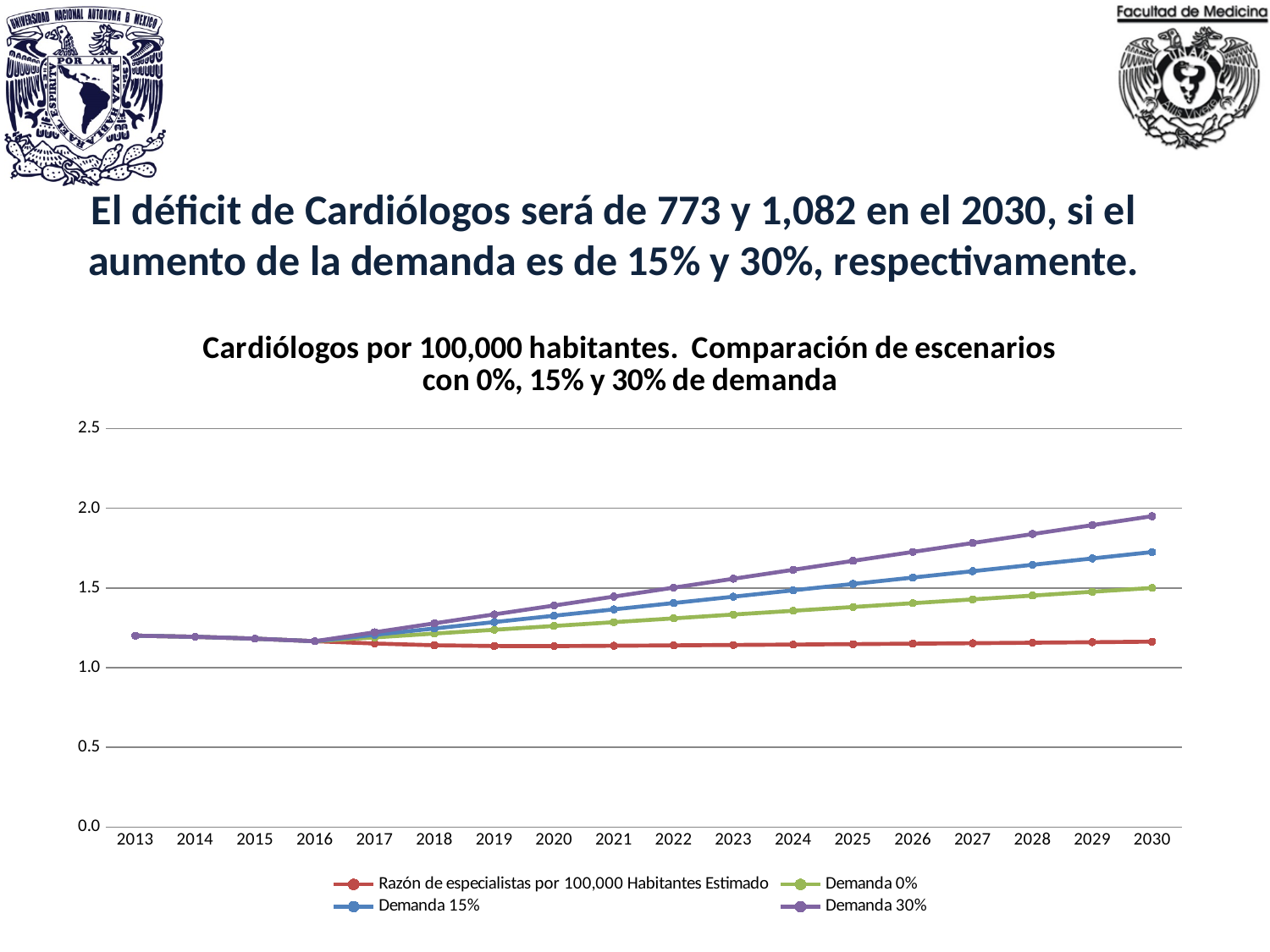
How many years are shown along the x axis? 18 Is the value for Demanda 15% in 2030 greater or less than 1.5? greater Which series has the lowest value in 2030? Razón de especialistas por 100,000 Habitantes Estimado Which series has the highest value in 2030? Demanda 30% How many series does the legend list? 4 Which series is drawn in red? Razón de especialistas por 100,000 Habitantes Estimado Does the Demanda 30% series rise or fall from 2016 to 2030? rise What kind of chart is shown on the slide? line chart Is the value for Razón de especialistas por 100,000 Habitantes Estimado in 2030 greater or less than 1.5? less Is the value for Demanda 30% in 2030 greater or less than 2.0? less In 2030, which is larger: Demanda 15% or Demanda 0%? Demanda 15% What is the first year shown on the x axis? 2013